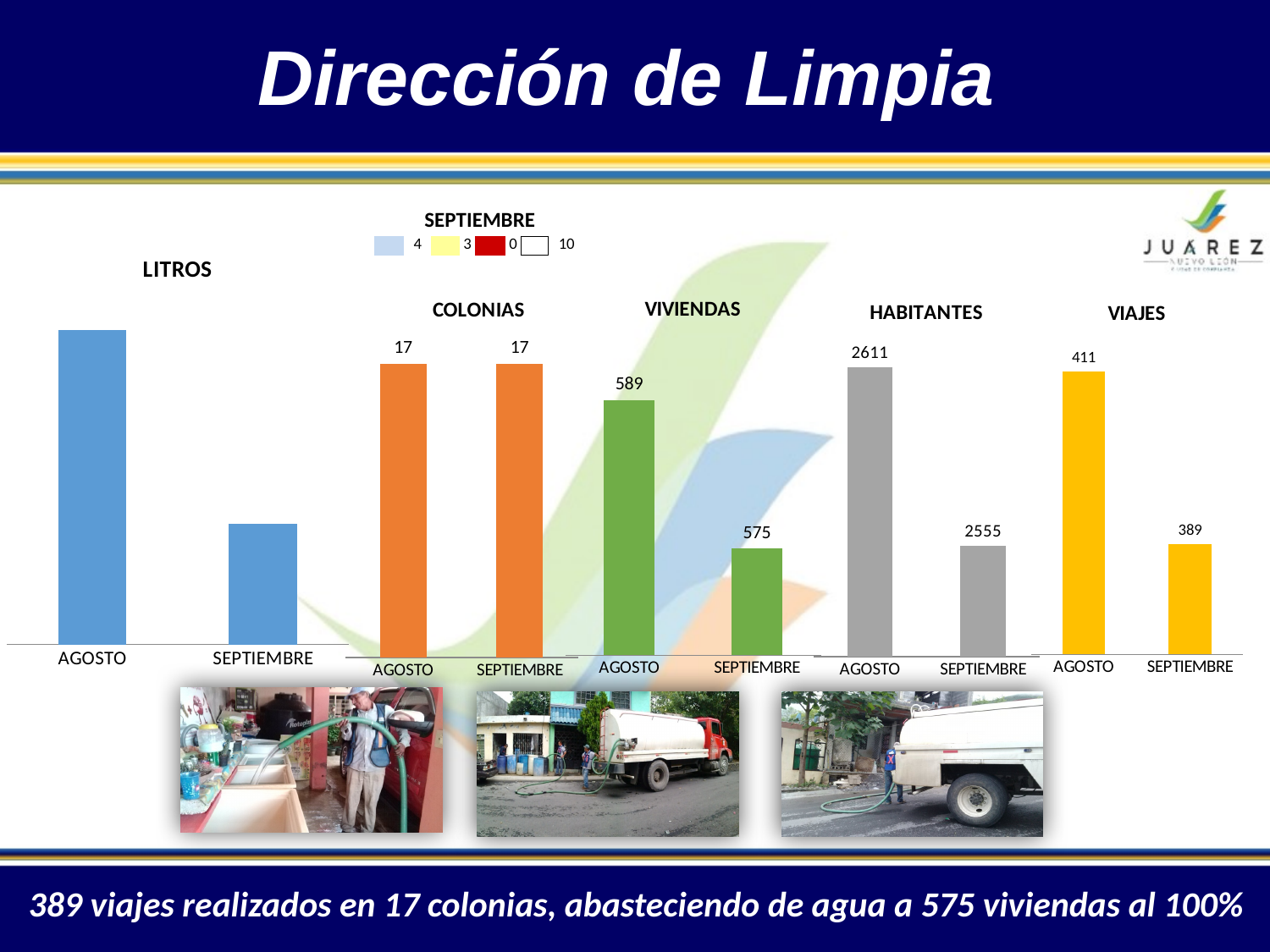
In the VIVIENDAS chart, what is the difference between the AGOSTO and SEPTIEMBRE values? 14 In the HABITANTES chart, do the values rise or fall from AGOSTO to SEPTIEMBRE? fall In the VIAJES chart, which month has the higher value, AGOSTO or SEPTIEMBRE? AGOSTO In the VIAJES chart, what is the value for SEPTIEMBRE? 389 In the HABITANTES chart, what is the value for AGOSTO? 2611 How many categories does the COLONIAS chart show? 2 What kind of chart is the VIVIENDAS chart? bar chart In the VIAJES chart, which month has the lowest value? SEPTIEMBRE In the LITROS chart, which bar is taller, AGOSTO or SEPTIEMBRE? AGOSTO In the HABITANTES chart, what is the difference between the AGOSTO and SEPTIEMBRE values? 56 In the VIVIENDAS chart, what is the value for SEPTIEMBRE? 575 In the COLONIAS chart, what is the value for AGOSTO? 17